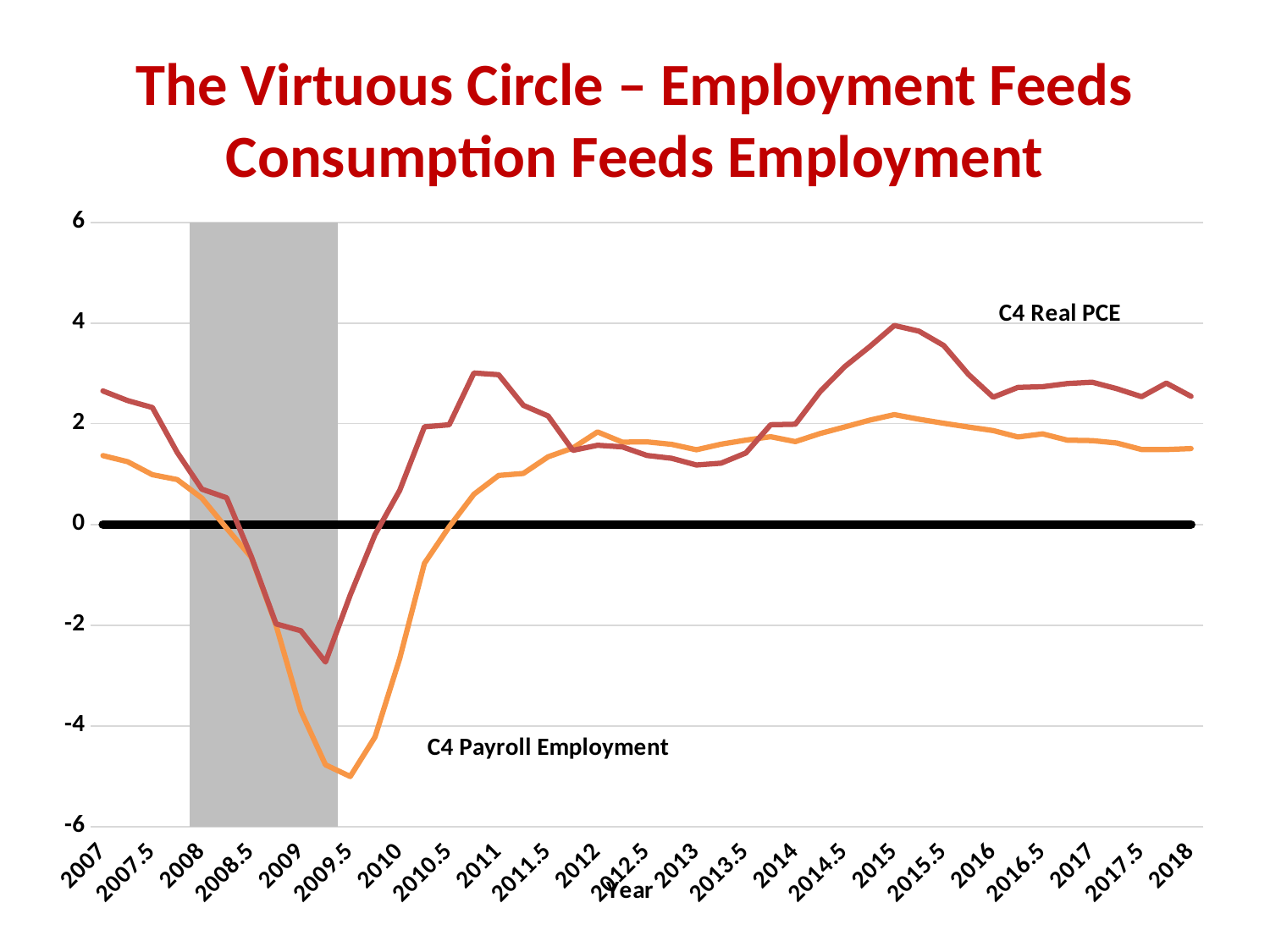
Which series reaches the lowest value on the chart? C4 Payroll Employment Is the value of C4 Payroll Employment at 2009.5 greater or less than -4? less How many data series are plotted on the chart? 2 Does C4 Payroll Employment rise or fall between 2008 and 2009.5? Fall At 2009.5, which series has the higher value, C4 Real PCE or C4 Payroll Employment? C4 Real PCE What kind of chart is shown on the slide? Line chart Is the value of C4 Real PCE at 2009.5 greater or less than -2? greater Is the value of C4 Real PCE at 2007 greater or less than 2? greater At 2015, which series has the higher value, C4 Real PCE or C4 Payroll Employment? C4 Real PCE What are the names of the two series plotted on the chart? C4 Real PCE and C4 Payroll Employment What is the title of the x axis? Year